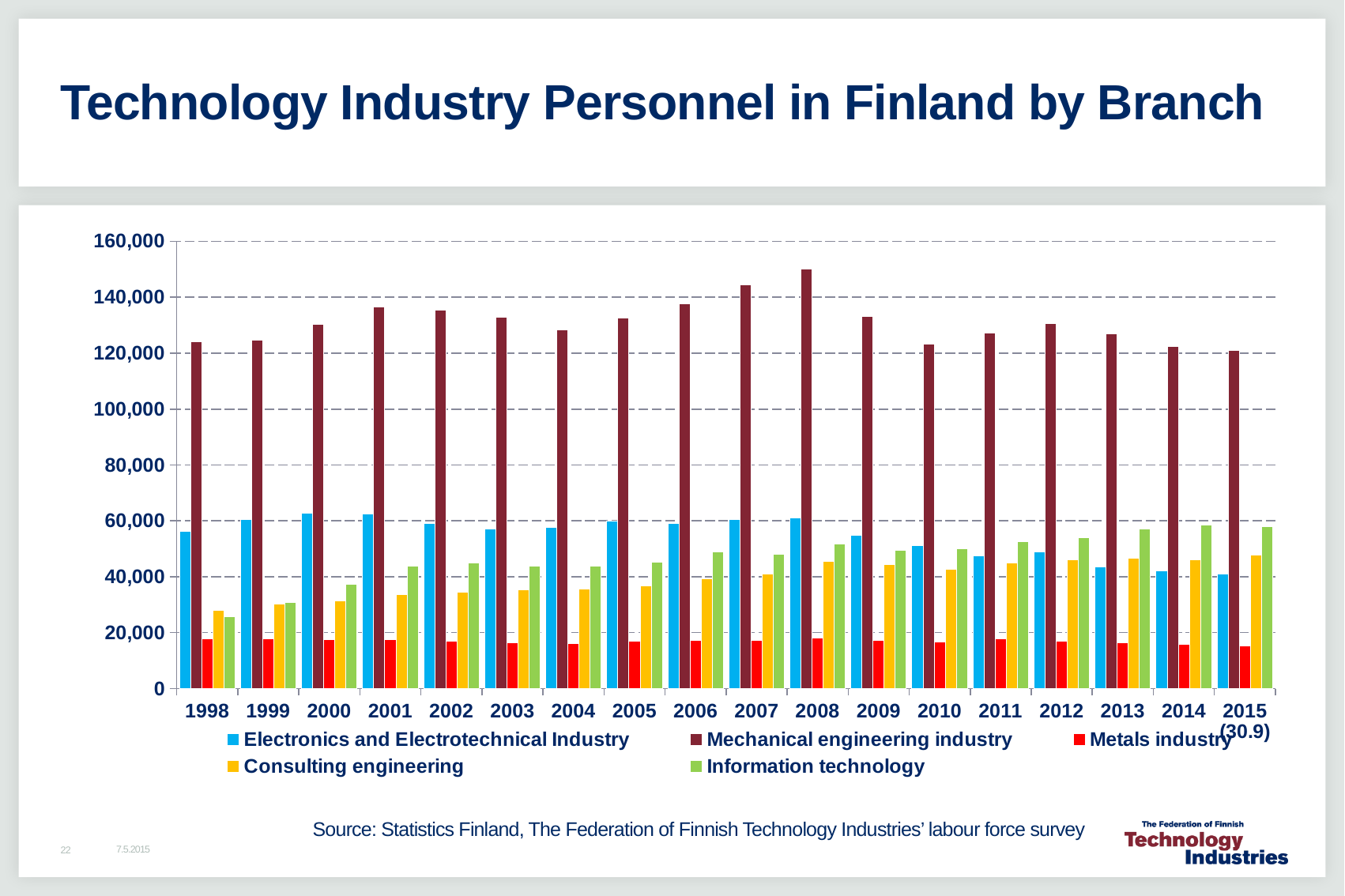
In which year is the value for Mechanical engineering industry highest? 2008 Is the value for Metals industry in 1998 greater or less than 20,000? less Is the value for Consulting engineering in 1998 greater or less than 40,000? less How many years are shown along the x axis? 18 What kind of chart is shown on the slide? bar chart Which series has the lowest value in every year shown? Metals industry In 1998, which is larger: Electronics and Electrotechnical Industry or Information technology? Electronics and Electrotechnical Industry How many series does the legend list? 5 Does the value for Information technology generally rise or fall from 1998 to 2015? rise Is the value for Information technology in 2015 (30.9) greater or less than 40,000? greater In 2015 (30.9), which is larger: Information technology or Electronics and Electrotechnical Industry? Information technology